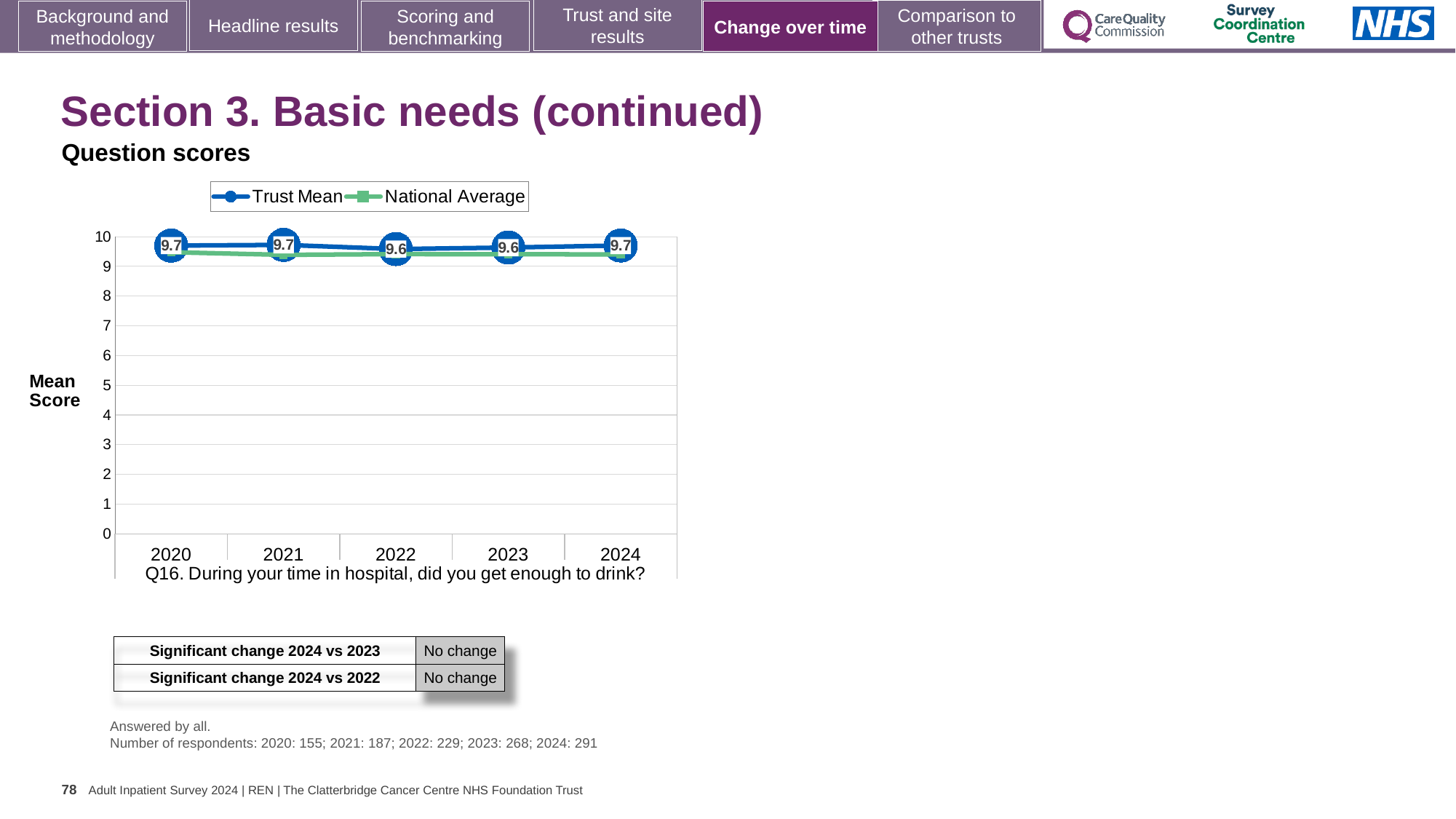
What is the difference between the Trust Mean scores for 2021 and 2022? 0.1 What is the Trust Mean score for 2024 on the Q16 chart? 9.7 How many years are shown on the x axis of the chart? 5 What kind of chart is shown on the slide? Line chart Which series is drawn in green on the chart? National Average Is the National Average value for 2024 greater or less than 9? greater Is the Trust Mean score for 2021 greater or less than 9? greater What is the Trust Mean score for 2020 on the Q16 chart? 9.7 What is the Trust Mean score for 2023 on the Q16 chart? 9.6 What is the Trust Mean score for 2022 on the Q16 chart? 9.6 What is the label of the y axis on the chart? Mean Score How many series does the chart legend list? 2